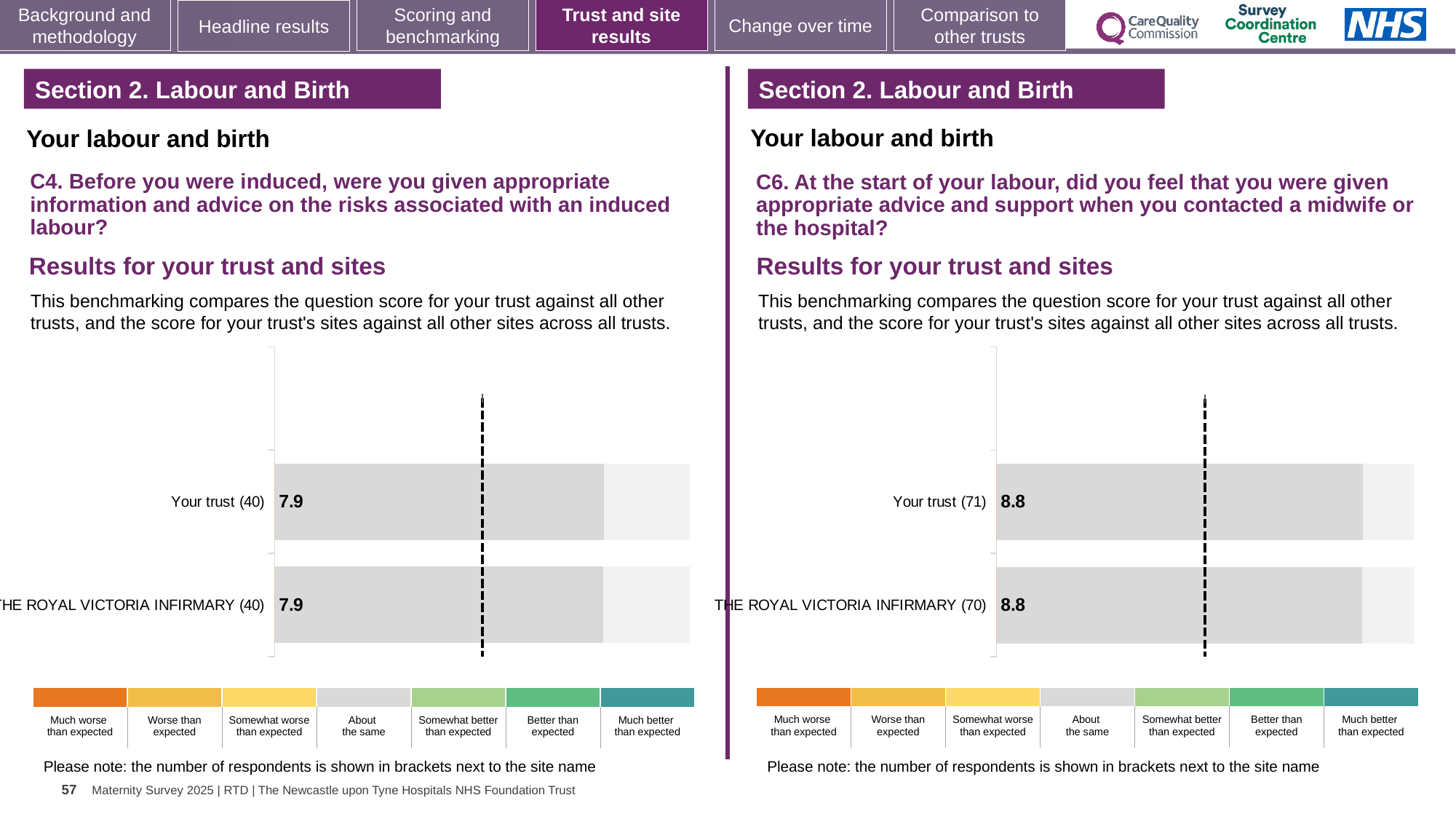
In the left chart (C4), what is the difference between the score for Your trust and the score for THE ROYAL VICTORIA INFIRMARY? 0 In the right chart (C6), what is the difference between the score for Your trust and the score for THE ROYAL VICTORIA INFIRMARY? 0 In the left chart (C4), what is the score for THE ROYAL VICTORIA INFIRMARY? 7.9 In the right chart (C6), what is the score for THE ROYAL VICTORIA INFIRMARY? 8.8 How many bars are plotted in the left chart (C4)? 2 In the left chart (C4), what is the score for Your trust? 7.9 What kind of chart is used on the left side of the slide (C4)? Bar chart How many categories does the colour key below the right chart (C6) list? 7 In the right chart (C6), how many respondents are shown in brackets next to THE ROYAL VICTORIA INFIRMARY? 70 How many bars are plotted in the right chart (C6)? 2 In the right chart (C6), what is the score for Your trust? 8.8 In the left chart (C4), how many respondents are shown in brackets next to Your trust? 40